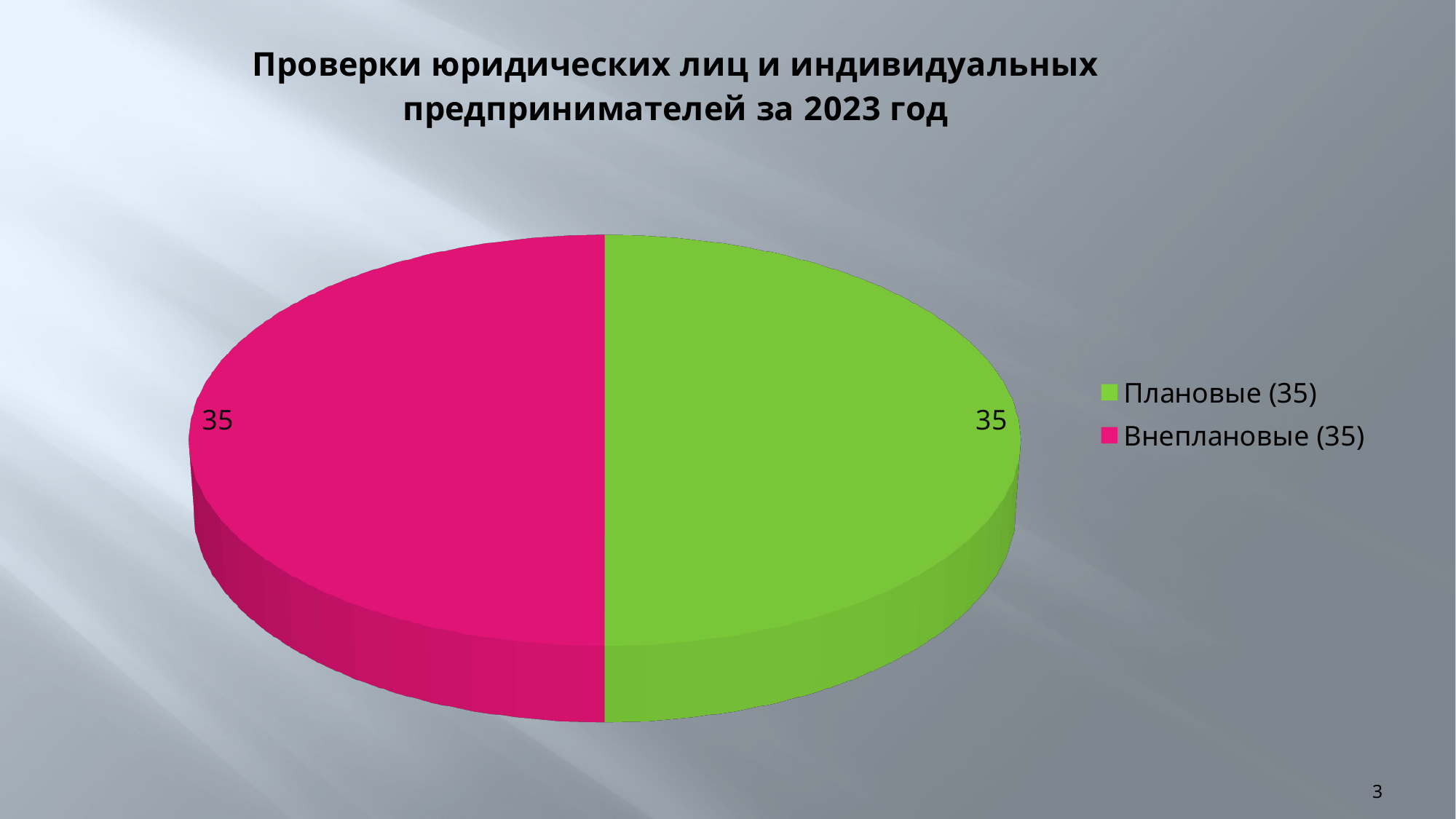
How many slices does the pie chart have? 2 How many entries does the legend list? 2 What is the total of the two slices in the pie chart? 70 What is the value for Внеплановые? 35 What share of the pie does the Внеплановые slice represent? 50% Which colour represents Внеплановые in the pie chart? pink What share of the pie does the Плановые slice represent? 50% What is the value for Плановые? 35 What kind of chart is shown on the slide? pie chart What is the difference between the values for Плановые and Внеплановые? 0 What is the title of the chart? Проверки юридических лиц и индивидуальных предпринимателей за 2023 год